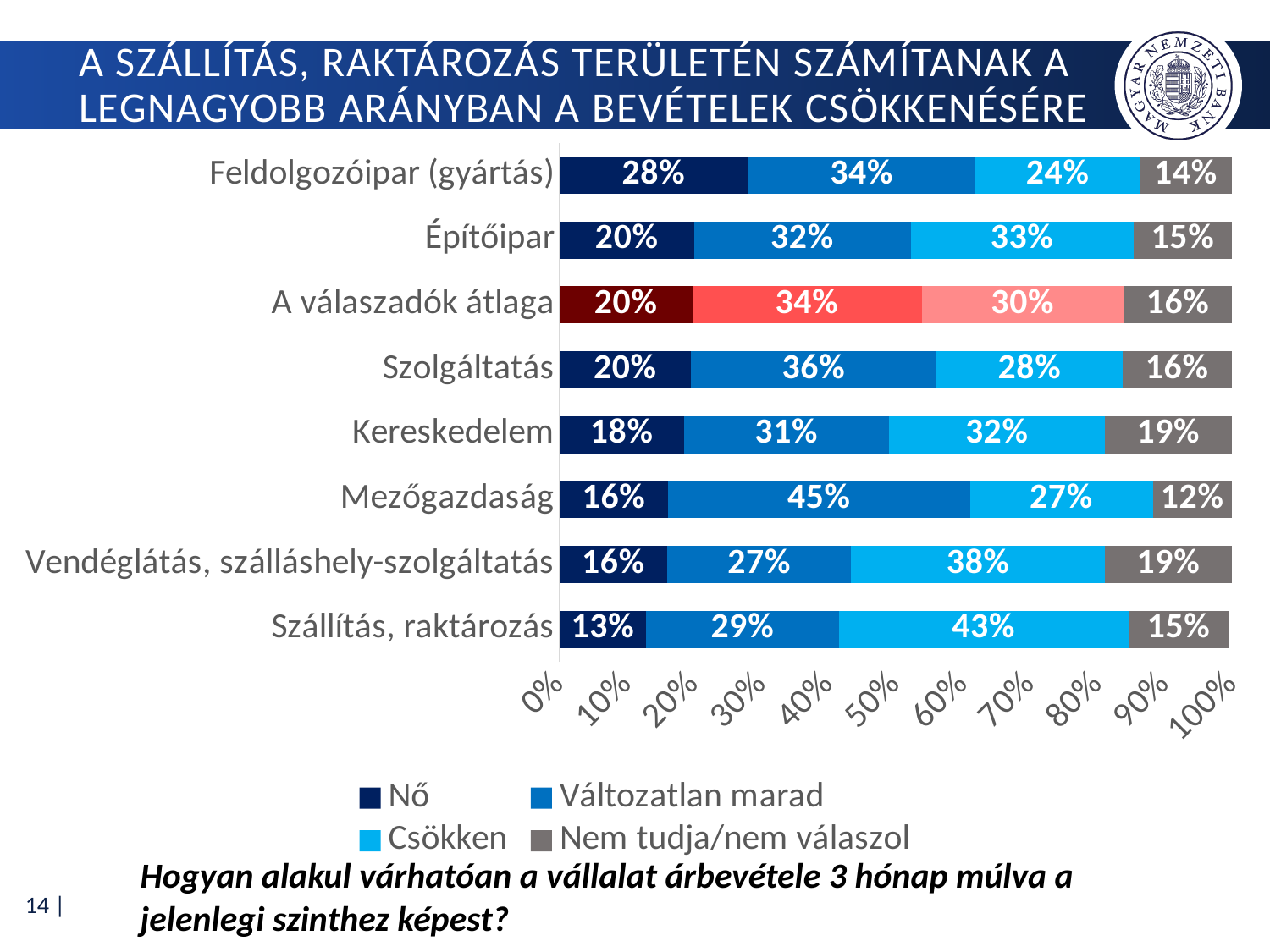
What kind of chart is shown on the slide? Stacked bar chart Which category has the lowest "Nő" value? Szállítás, raktározás What is the total of the stacked bar for Vendéglátás, szálláshely-szolgáltatás? 100% How many categories are shown on the chart? 8 What is the value of "Csökken" for Szállítás, raktározás? 43% What is the difference between the "Csökken" values for Szállítás, raktározás and Feldolgozóipar (gyártás)? 19 percentage points What is the value of "Nem tudja/nem válaszol" for Kereskedelem? 19% Which is larger: the "Változatlan marad" value for Szolgáltatás or for Építőipar? Szolgáltatás What is the value of "Nő" for Feldolgozóipar (gyártás)? 28% How many series does the legend list? 4 Which category has the highest "Csökken" value? Szállítás, raktározás What is the value of "Változatlan marad" for Mezőgazdaság? 45%